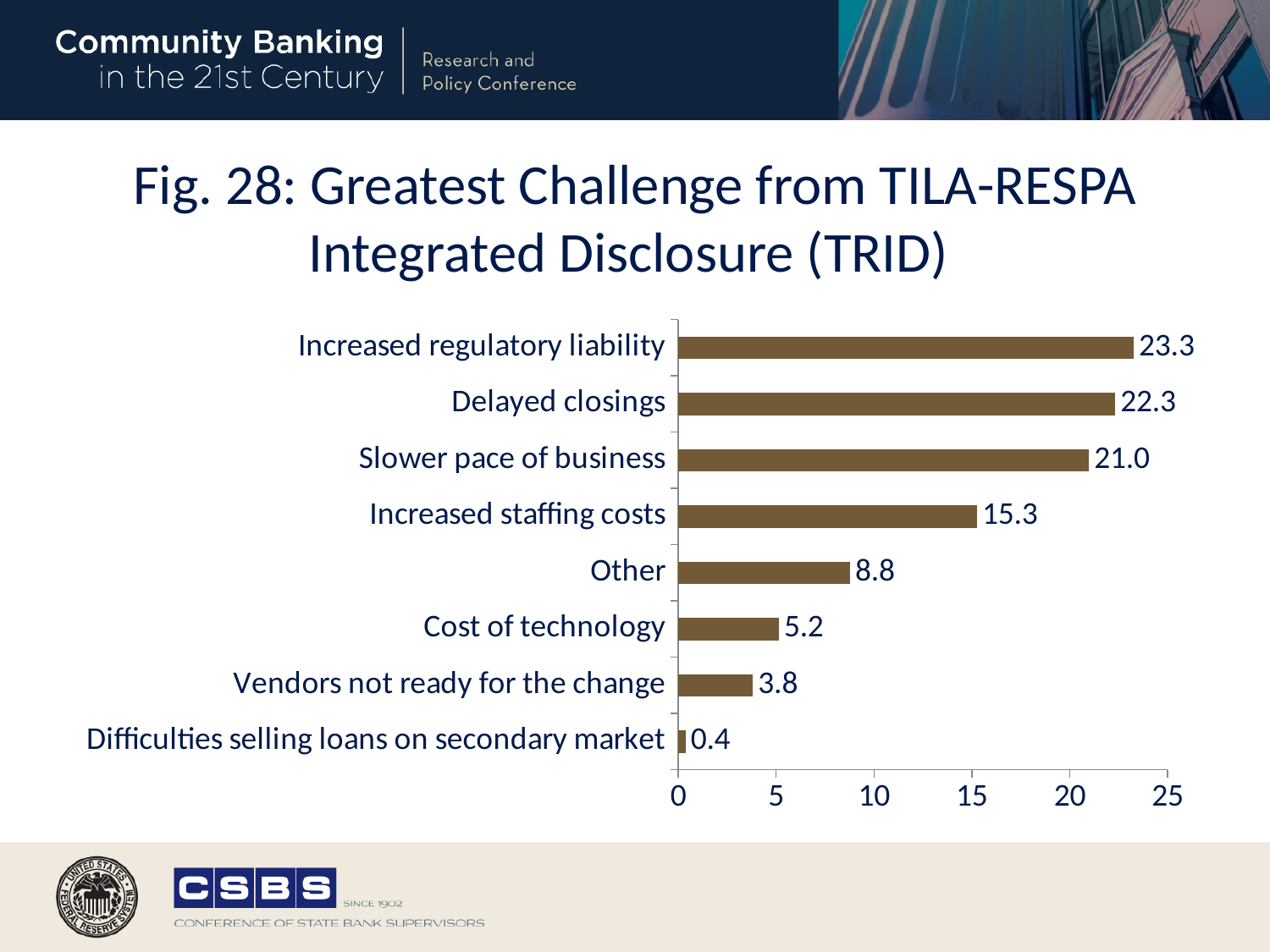
What kind of chart is shown on the slide? bar chart What is the value for Vendors not ready for the change? 3.8 What is the value for Increased regulatory liability? 23.3 Which category has the highest value? Increased regulatory liability What is the difference between the values for Other and Cost of technology? 3.6 What is the value for Increased staffing costs? 15.3 What is the difference between the values for Delayed closings and Slower pace of business? 1.3 How many categories are shown in the chart? 8 What is the title of the chart? Fig. 28: Greatest Challenge from TILA-RESPA Integrated Disclosure (TRID) Which category has the lowest value? Difficulties selling loans on secondary market Is the value for Slower pace of business greater or less than 20? greater Which is larger, the value for Increased staffing costs or the value for Other? Increased staffing costs